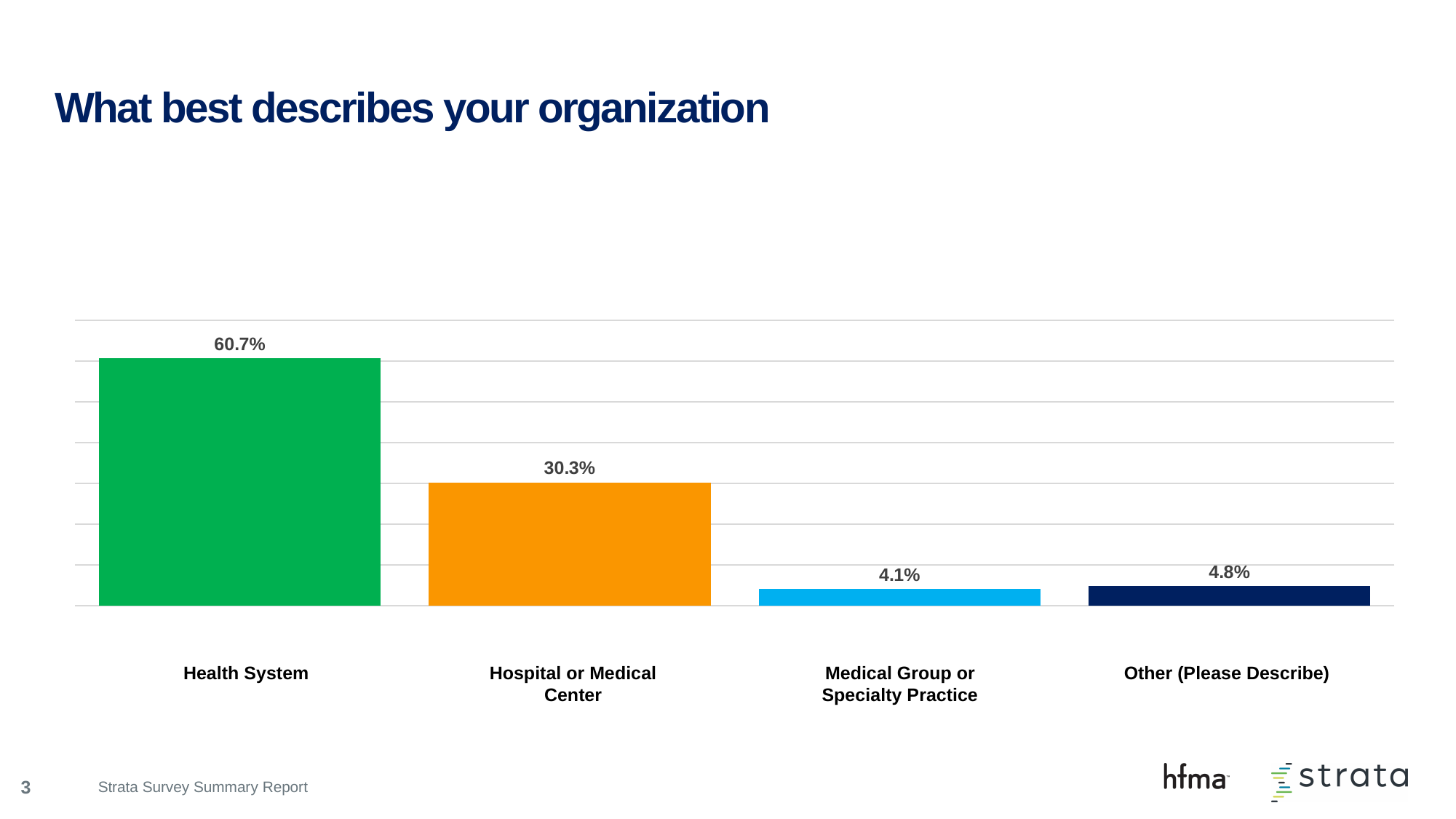
How many organization categories are shown in the chart? 4 Which organization type has the highest percentage? Health System Which organization type has the lowest percentage? Medical Group or Specialty Practice What colour is the bar for Hospital or Medical Center? Orange What is the difference in percentage points between Other (Please Describe) and Medical Group or Specialty Practice? 0.7 What percentage of respondents described their organization as a Health System? 60.7% Which is larger, the value for Hospital or Medical Center or the value for Other (Please Describe)? Hospital or Medical Center What is the difference in percentage points between Health System and Hospital or Medical Center? 30.4 What is the value shown for Other (Please Describe)? 4.8% What is the value shown for Medical Group or Specialty Practice? 4.1% What kind of chart is shown on the slide? Bar chart What is the value shown for Hospital or Medical Center? 30.3%